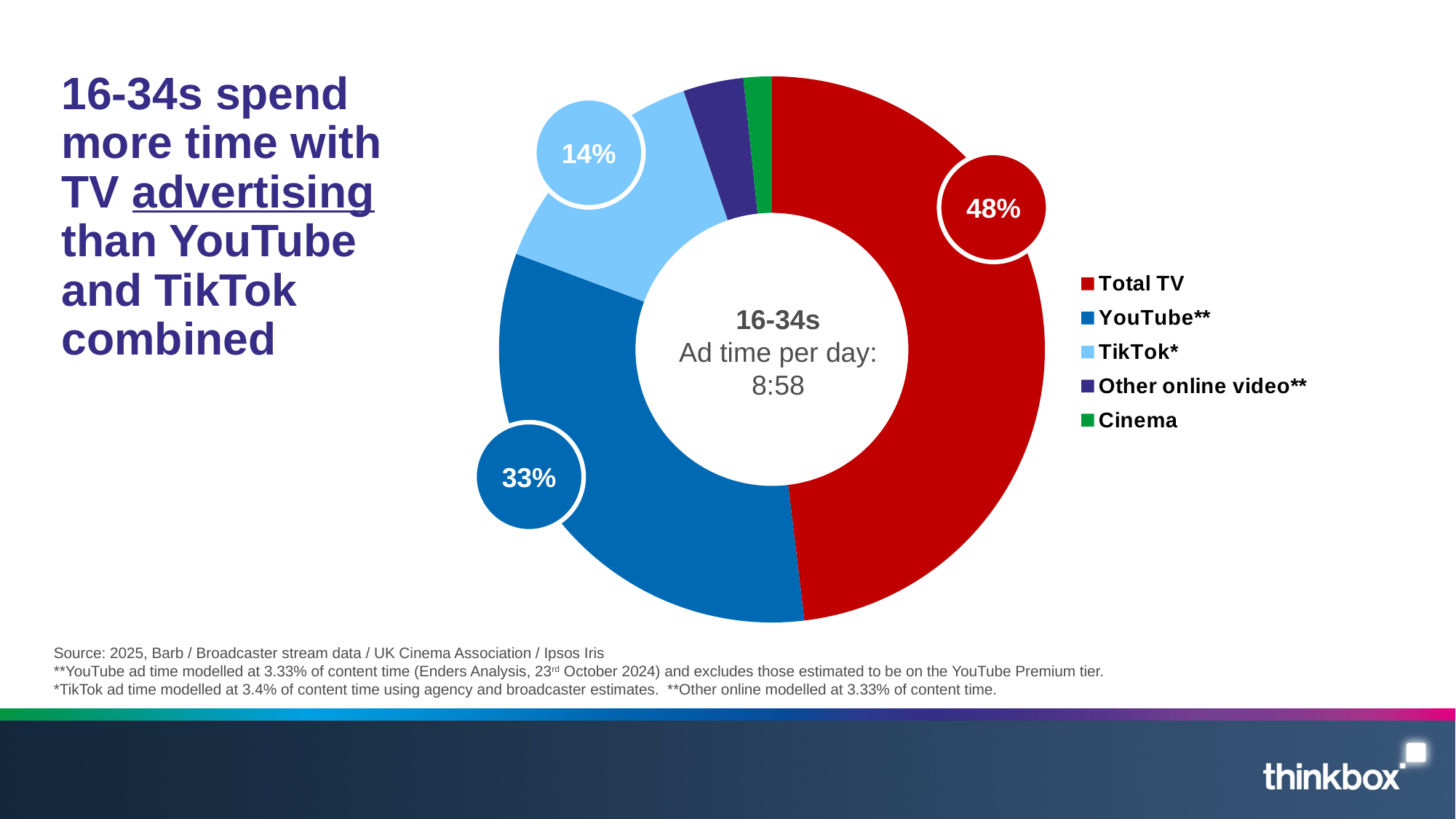
What colour is the Total TV segment of the chart? Red Which is larger, the share for YouTube** or the share for TikTok*? YouTube** What share of ad time per day for 16-34s does YouTube** account for? 33% What share of ad time per day for 16-34s does TikTok* account for? 14% Which category has the largest share of the donut chart? Total TV What total ad time per day is shown in the centre of the chart for 16-34s? 8:58 What kind of chart is shown on the slide? Donut (pie) chart What share of ad time per day for 16-34s does Total TV account for? 48% How many categories does the legend of the chart list? 5 What is the difference in percentage points between the Total TV share and the YouTube** share? 15 What is the combined share of YouTube** and TikTok*? 47% Which category has the smallest share of the donut chart? Cinema